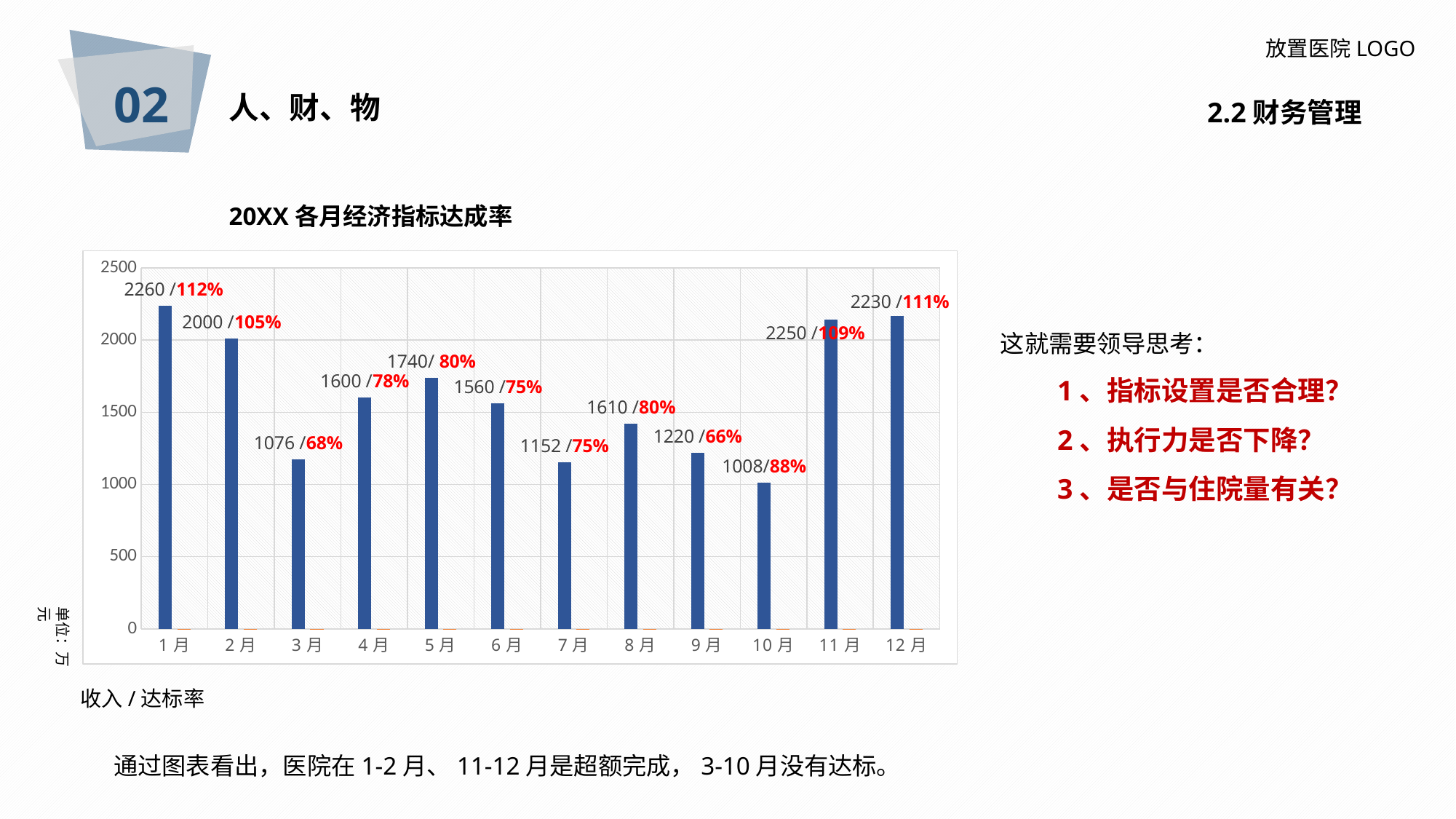
What is the difference between the income values for 1月 and 10月? 1252 What is the title of the chart? 20XX 各月经济指标达成率 Which month has the lowest income value? 10月 Which month has the highest income value? 1月 What achievement rate is shown for 11月? 109% What achievement rate is shown for 3月? 68% What is the income value shown for 1月? 2260 How many months are shown on the x axis? 12 Which has a larger income value, 5月 or 6月? 5月 Is the income value for 9月 greater or less than 1500? less What kind of chart is shown on the slide? bar chart What is the income value shown for 10月? 1008